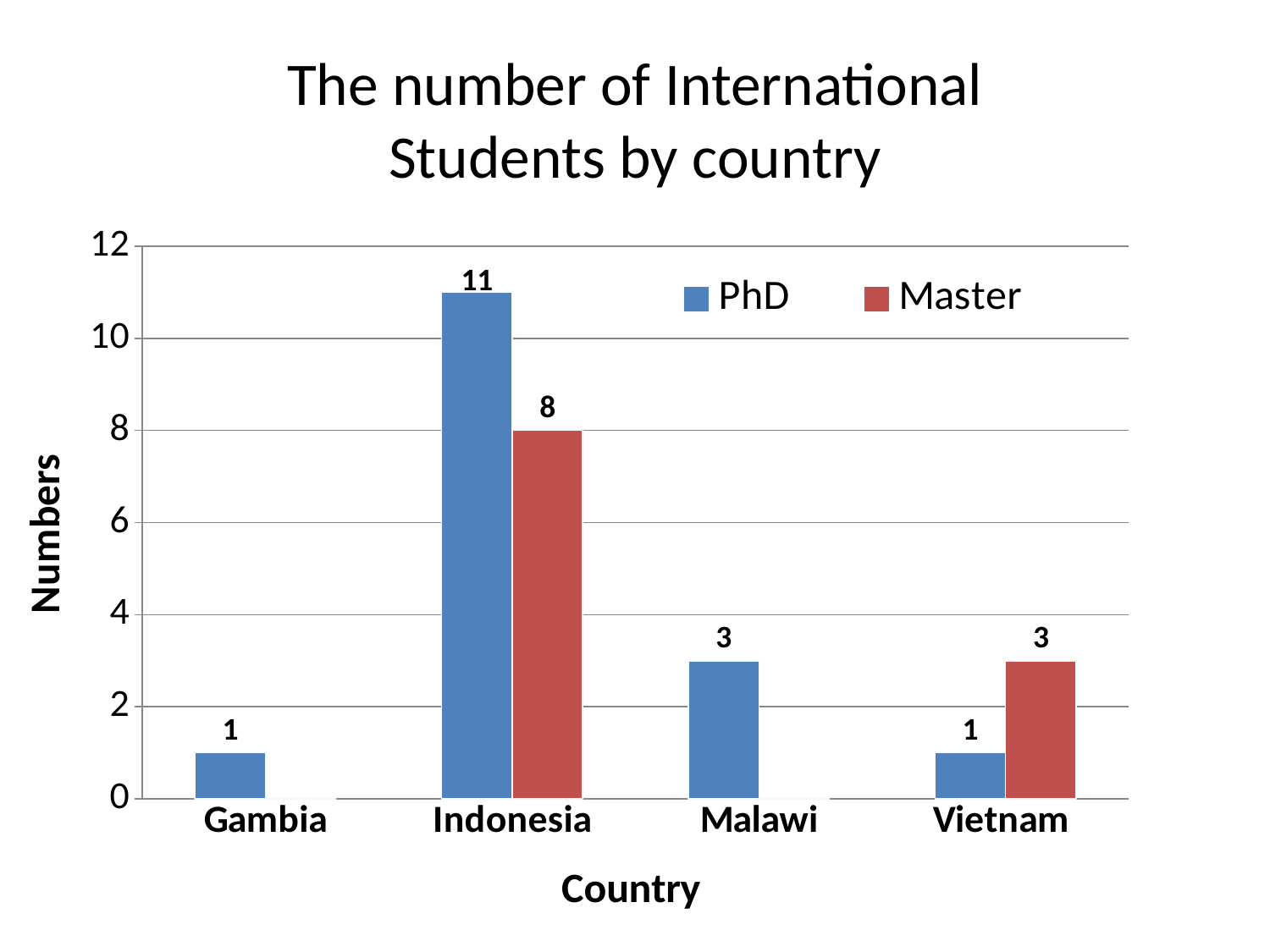
What is the title of the chart? The number of International Students by country Which country has the highest number of PhD students? Indonesia What kind of chart is shown on the slide? Bar chart Which country has the highest number of Master students? Indonesia Which is larger for Vietnam, the number of PhD students or the number of Master students? Master What is the difference between the number of PhD and Master students from Indonesia? 3 What is the number of Master students from Vietnam? 3 What is the number of PhD students from Malawi? 3 How many series does the legend list? 2 How many countries are shown on the x axis? 4 What is the number of Master students from Indonesia? 8 What is the number of PhD students from Indonesia? 11